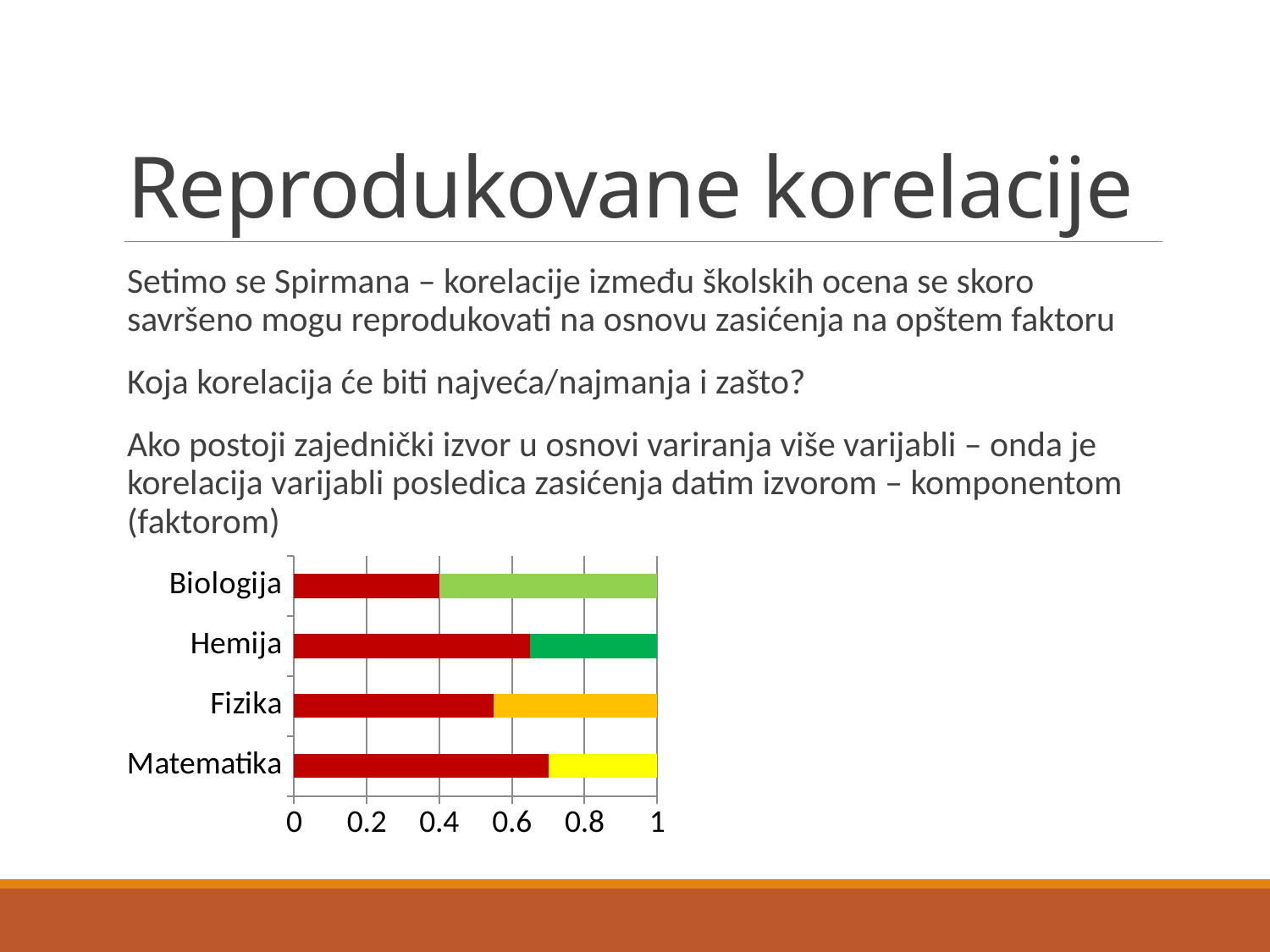
Is the red segment for Hemija greater or less than 0.6? greater Is the red segment for Matematika greater or less than 0.6? greater Which categories are listed on the vertical axis of the chart? Biologija, Hemija, Fizika, Matematika Which category has the shortest red segment? Biologija Which category has the longest red segment? Matematika What colour is the second segment of the Matematika bar? Yellow How many categories are shown on the chart? 4 What is the total length of the stacked bar for Biologija? 1 Is the red segment for Fizika greater or less than 0.6? less Which has the longer red segment, Hemija or Fizika? Hemija What value does the red segment for Biologija reach? 0.4 What kind of chart is shown on the slide? Stacked bar chart